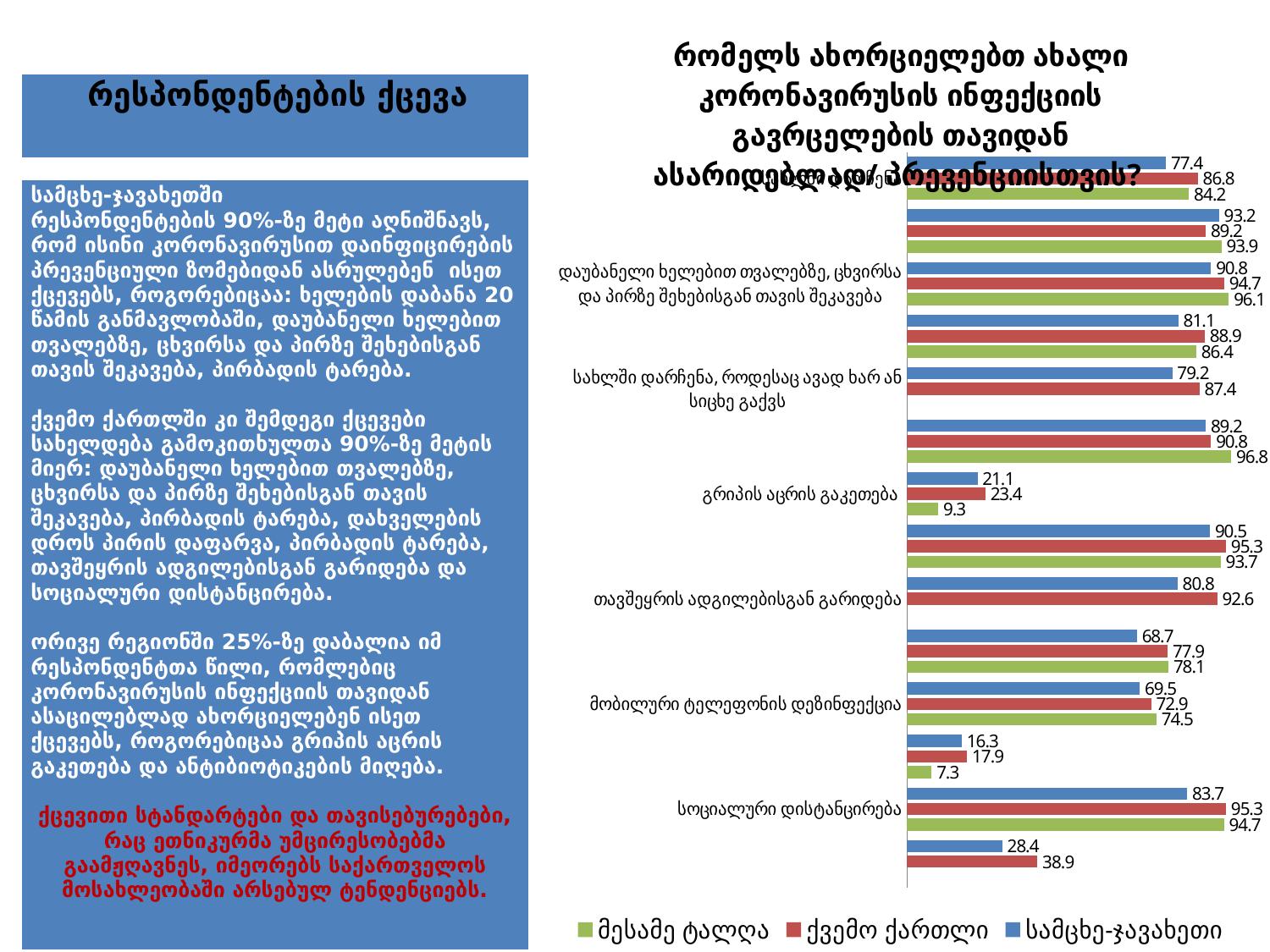
What is the value for მესამე ტალღა for მობილური ტელეფონის დეზინფექცია? 74.5 Which colour represents ქვემო ქართლი in the chart? red Which is larger for სოციალური დისტანცირება: the value for სამცხე-ჯავახეთი or for მესამე ტალღა? მესამე ტალღა What is the difference between the მესამე ტალღა and სამცხე-ჯავახეთი values for მობილური ტელეფონის დეზინფექცია? 5.0 What is the value for ქვემო ქართლი for სოციალური დისტანცირება? 95.3 Which series has the lowest value for გრიპის აცრის გაკეთება? მესამე ტალღა What is the value for ქვემო ქართლი for თავშეყრის ადგილებისგან გარიდება? 92.6 What is the difference between the ქვემო ქართლი and სამცხე-ჯავახეთი values for სახლში დარჩენა, როდესაც ავად ხარ ან სიცხე გაქვს? 8.2 What is the value for სამცხე-ჯავახეთი for გრიპის აცრის გაკეთება? 21.1 Which series has the highest value for დაუბანელი ხელებით თვალებზე, ცხვირსა და პირზე შეხებისგან თავის შეკავება? მესამე ტალღა What kind of chart is shown on the slide? bar chart How many series does the chart legend list? 3